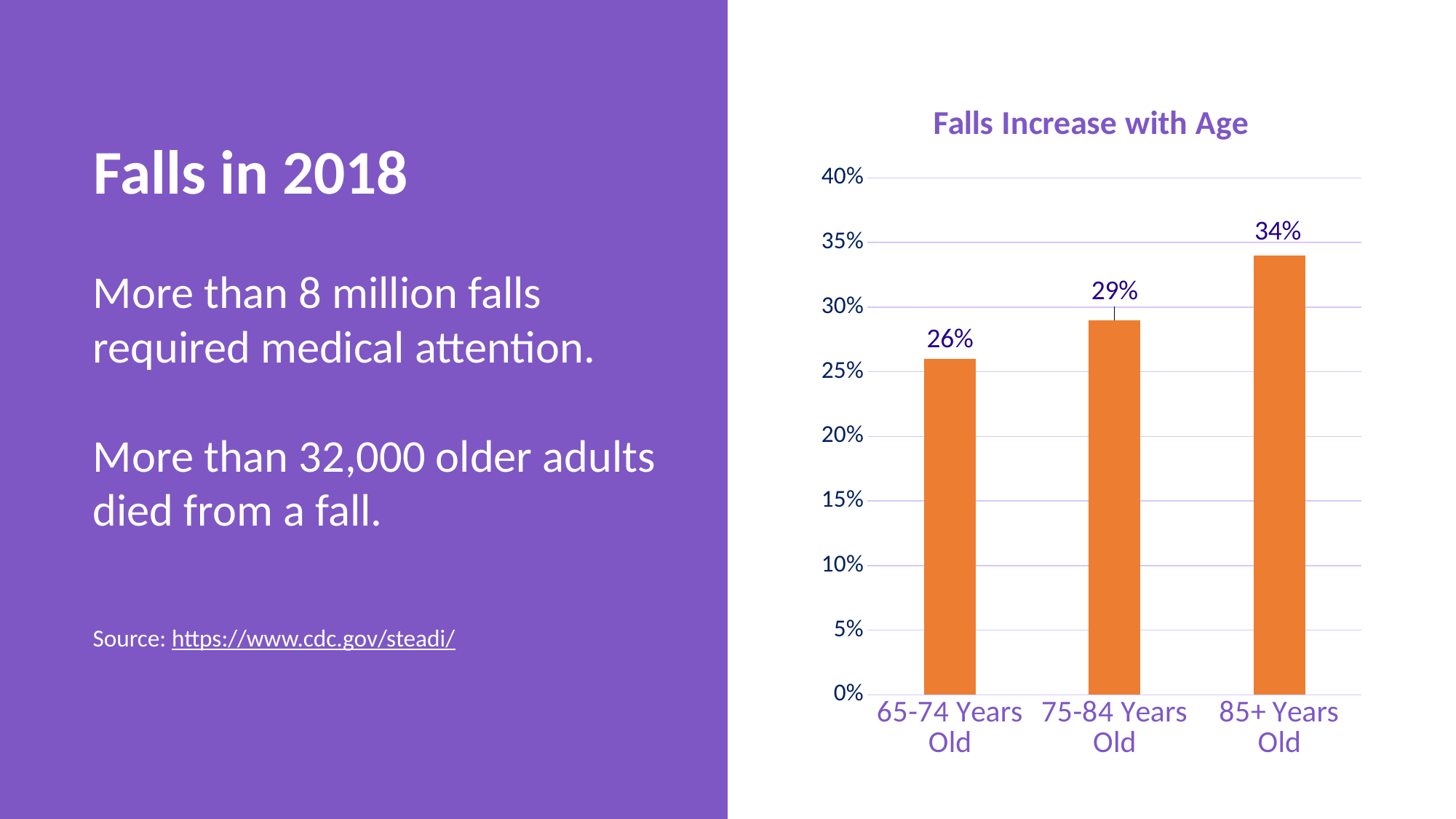
What is the value for 85+ Years Old? 34% What is the value for 75-84 Years Old? 29% Which is larger, the value for 75-84 Years Old or 85+ Years Old? 85+ Years Old How many age groups are shown in the chart? 3 What is the difference between the values for 75-84 Years Old and 65-74 Years Old? 3% Do the values rise or fall as age increases along the x axis? rise What kind of chart is shown on the slide? bar chart Which age group has the highest value? 85+ Years Old Which age group has the lowest value? 65-74 Years Old Is the value for 85+ Years Old greater or less than 30%? greater What is the difference between the values for 85+ Years Old and 65-74 Years Old? 8% What is the value for 65-74 Years Old? 26%